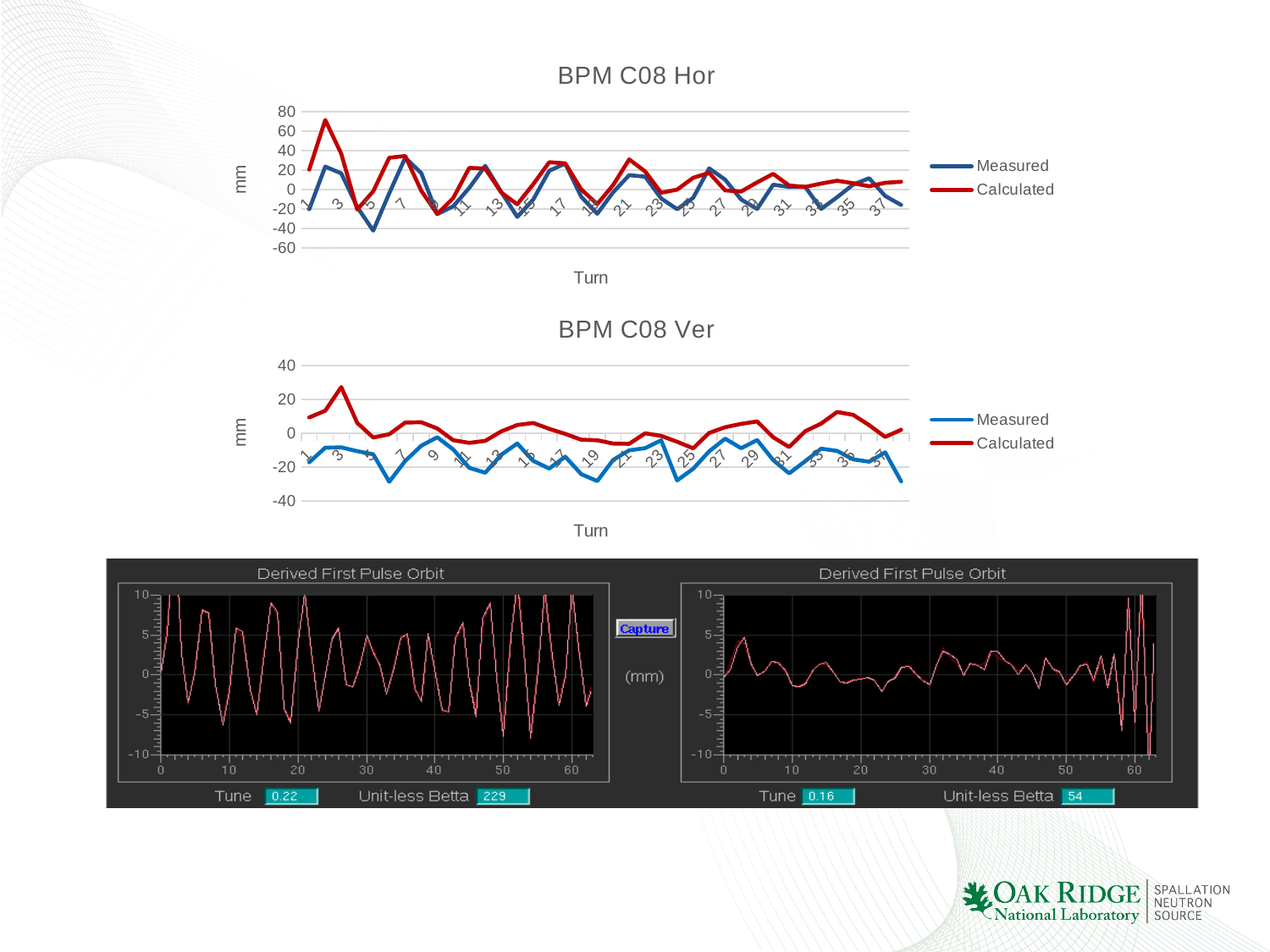
In "BPM C08 Ver", is the peak value of the Calculated series near turn 3 greater or less than 20? greater How many series does the legend of "BPM C08 Hor" list? 2 What Tune value is shown under the left "Derived First Pulse Orbit" plot? 0.22 In "BPM C08 Ver", which series is higher at turn 3, Measured or Calculated? Calculated In "BPM C08 Hor", does the size of the oscillations grow or shrink as Turn increases? shrink In "BPM C08 Hor", is the lowest value of the Measured series near turn 5 greater or less than -20? less In "BPM C08 Hor", which series reaches the higher value at turn 2, Measured or Calculated? Calculated What kind of chart is "BPM C08 Hor"? line chart In "BPM C08 Ver", is the lowest value of the Measured series at the right end of the chart greater or less than -20? less How many series does the legend of "BPM C08 Ver" list? 2 In "BPM C08 Hor", what is the label of the x axis? Turn